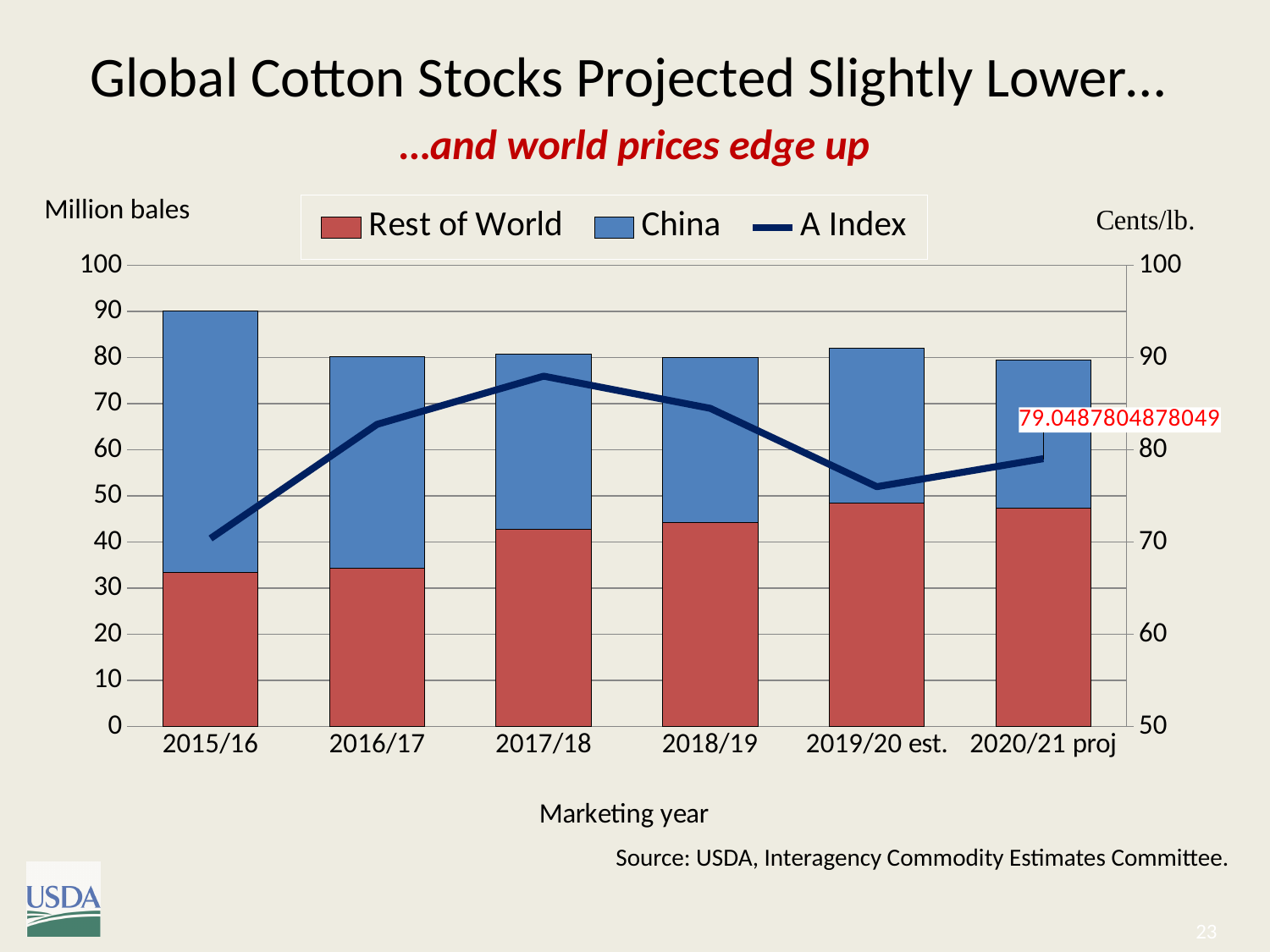
Does the Rest of World value rise or fall from 2015/16 to 2019/20 est.? rise Is the Rest of World value for 2015/16 greater or less than 40 million bales? less In which marketing year is the A Index lowest? 2015/16 What is the A Index value shown for 2020/21 proj? 79.0487804878049 What kind of chart is this? Stacked bar chart with a line How many marketing years are shown on the x axis? 6 In which marketing year is the A Index highest? 2017/18 Is the A Index value for 2019/20 est. greater or less than 80 cents/lb.? less What unit is shown on the right-hand axis? Cents/lb. How many series does the legend list? 3 Which is larger: the Rest of World value for 2015/16 or for 2019/20 est.? 2019/20 est. Which marketing year has the highest total stocks (Rest of World plus China)? 2015/16